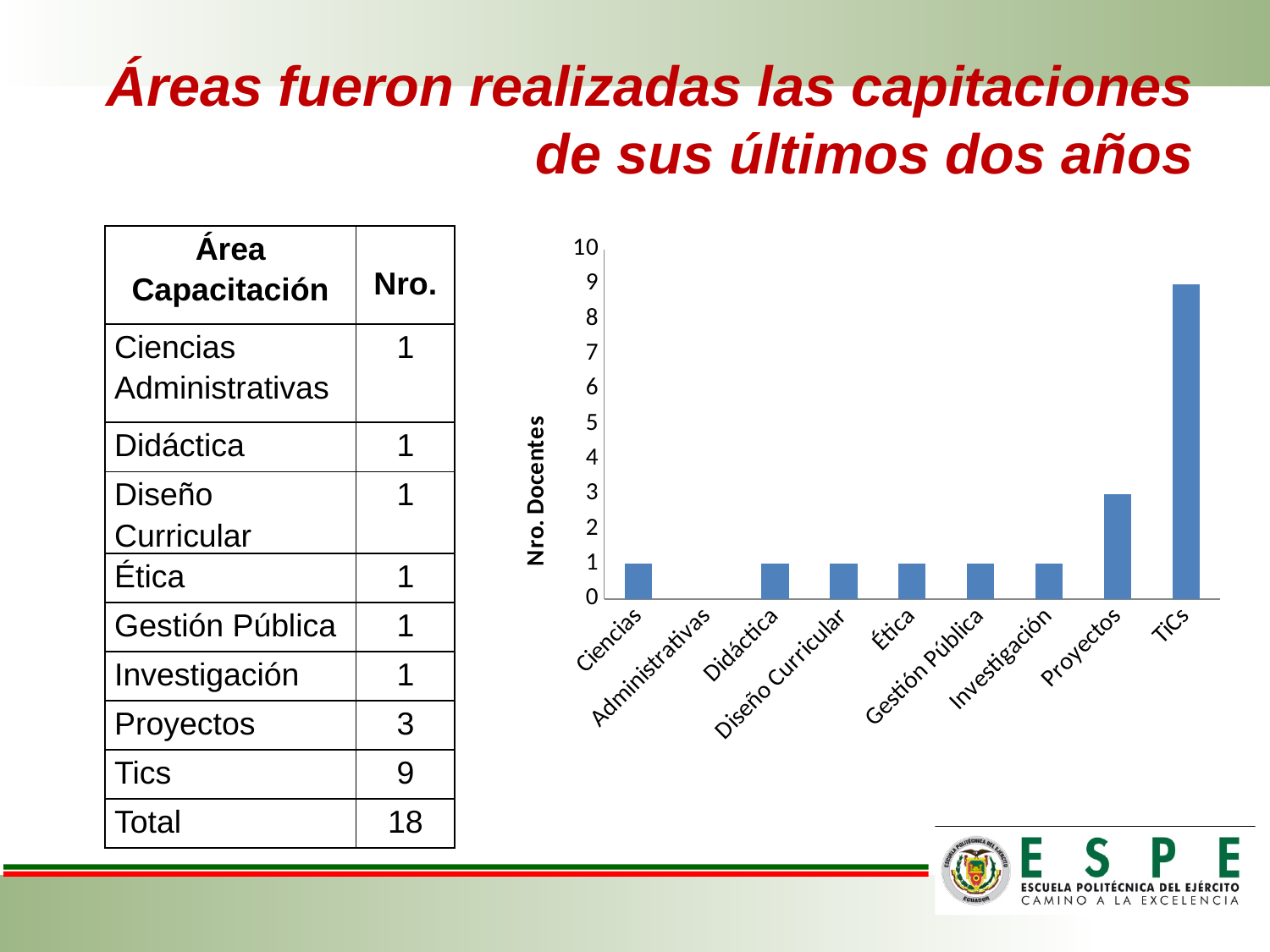
Is the value for Tics greater or less than 5? greater What is the difference between the values for Tics and Proyectos? 6 What is the value for Investigación in the chart? 1 Which is larger, the value for Proyectos or the value for Didáctica? Proyectos What is the value for Tics in the chart? 9 What is the highest value shown on the vertical axis of the chart? 10 What is the value for Proyectos in the chart? 3 How many categories are plotted on the x axis of the chart? 9 What is the label on the vertical axis of the chart? Nro. Docentes What kind of chart is shown on the slide? bar chart Which category has the highest bar in the chart? Tics What is the value for Ética in the chart? 1